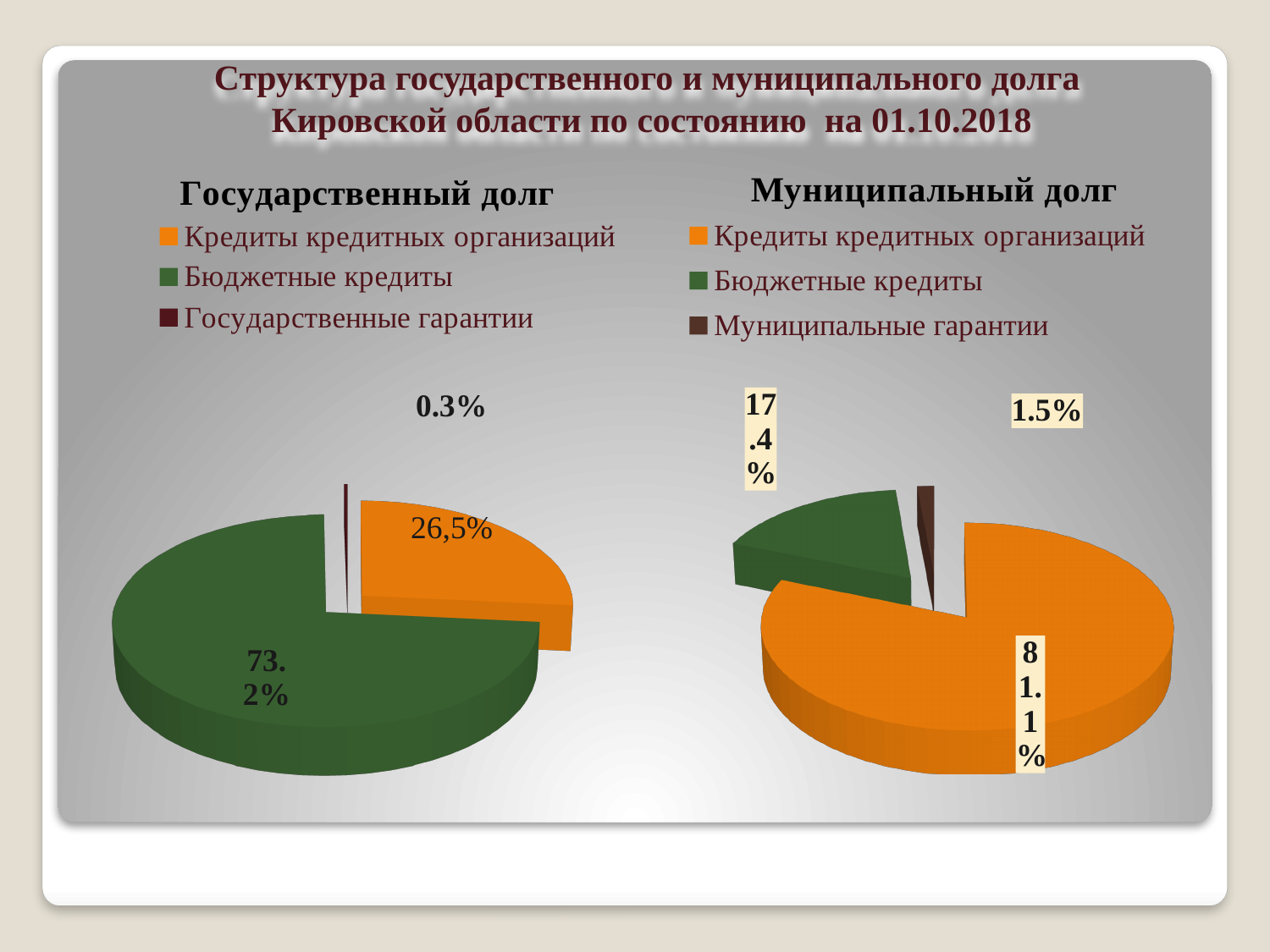
In the 'Государственный долг' chart, what share is shown for Кредиты кредитных организаций? 26,5% In the 'Государственный долг' chart, which category has the largest slice? Бюджетные кредиты How many categories does the legend of the 'Государственный долг' chart list? 3 In the 'Муниципальный долг' chart, which category has the smallest slice? Муниципальные гарантии In the 'Муниципальный долг' chart, what is the difference between the shares of Кредиты кредитных организаций and Бюджетные кредиты? 63.7% What type of chart is used for 'Муниципальный долг'? Pie chart In the 'Государственный долг' chart, what share is shown for Бюджетные кредиты? 73.2% In the 'Государственный долг' chart, what share is shown for Государственные гарантии? 0.3% In the 'Муниципальный долг' chart, what share is shown for Муниципальные гарантии? 1.5% In the 'Муниципальный долг' chart, what share is shown for Бюджетные кредиты? 17.4% In the 'Муниципальный долг' chart, what share is shown for Кредиты кредитных организаций? 81.1% In the 'Муниципальный долг' chart, which is larger: Кредиты кредитных организаций or Бюджетные кредиты? Кредиты кредитных организаций